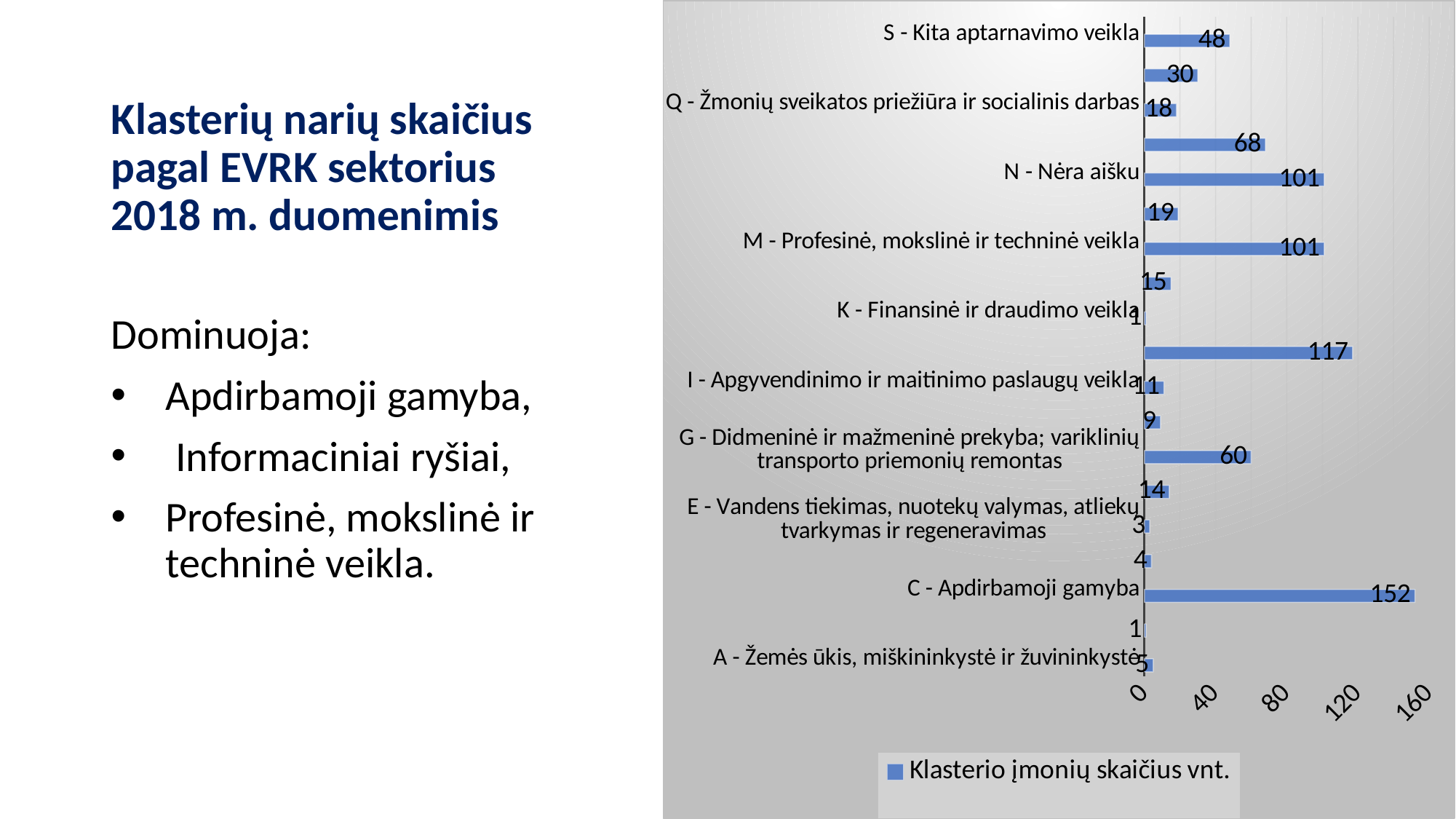
What is the value for C - Apdirbamoji gamyba? 152 What is the legend entry of the chart? Klasterio įmonių skaičius vnt. Which is larger: the value for S - Kita aptarnavimo veikla or the value for G - Didmeninė ir mažmeninė prekyba; variklinių transporto priemonių remontas? G - Didmeninė ir mažmeninė prekyba; variklinių transporto priemonių remontas How many series does the legend list? 1 Which category has the highest value? C - Apdirbamoji gamyba What is the value for M - Profesinė, mokslinė ir techninė veikla? 101 What is the value for S - Kita aptarnavimo veikla? 48 What is the difference between the values for C - Apdirbamoji gamyba and M - Profesinė, mokslinė ir techninė veikla? 51 What type of chart is shown on the slide? bar chart What is the value for Q - Žmonių sveikatos priežiūra ir socialinis darbas? 18 What is the value for G - Didmeninė ir mažmeninė prekyba; variklinių transporto priemonių remontas? 60 Is the value for N - Nėra aišku greater or less than 80? greater